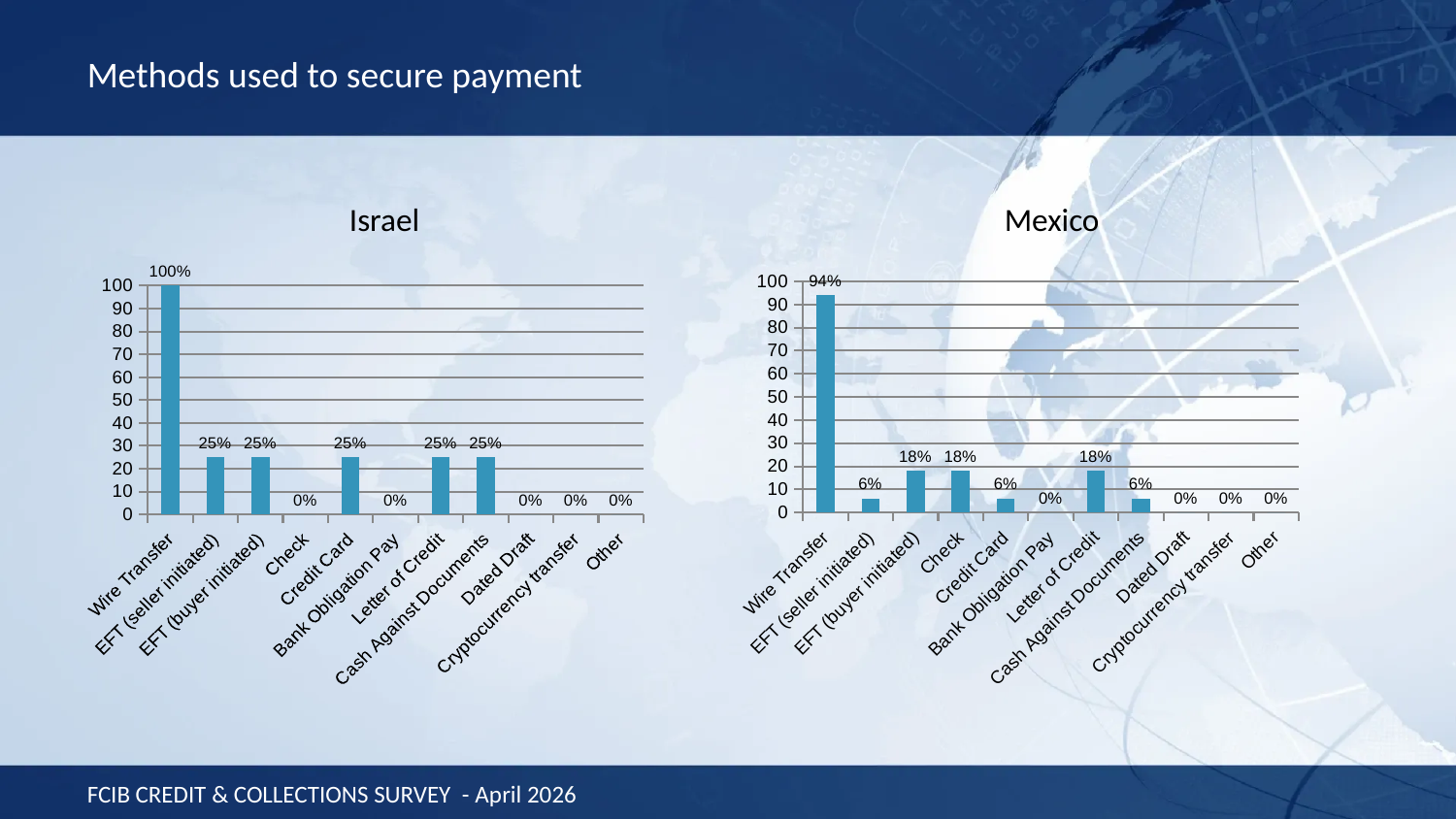
In the Mexico chart, what is the value for Cash Against Documents? 6% In the Mexico chart, what is the value for EFT (buyer initiated)? 18% In the Israel chart, what is the difference between Wire Transfer and Letter of Credit? 75% How many categories are shown on the x axis of the Israel chart? 11 In the Mexico chart, which is larger, EFT (seller initiated) or EFT (buyer initiated)? EFT (buyer initiated) In the Mexico chart, what is the difference between Check and Credit Card? 12% What is the title of the chart on the left? Israel In the Israel chart, what is the value for Wire Transfer? 100% In the Mexico chart, which category has the highest value? Wire Transfer What kind of chart is the Mexico chart? Bar chart In the Mexico chart, what is the value for Wire Transfer? 94% In the Israel chart, what is the value for Credit Card? 25%